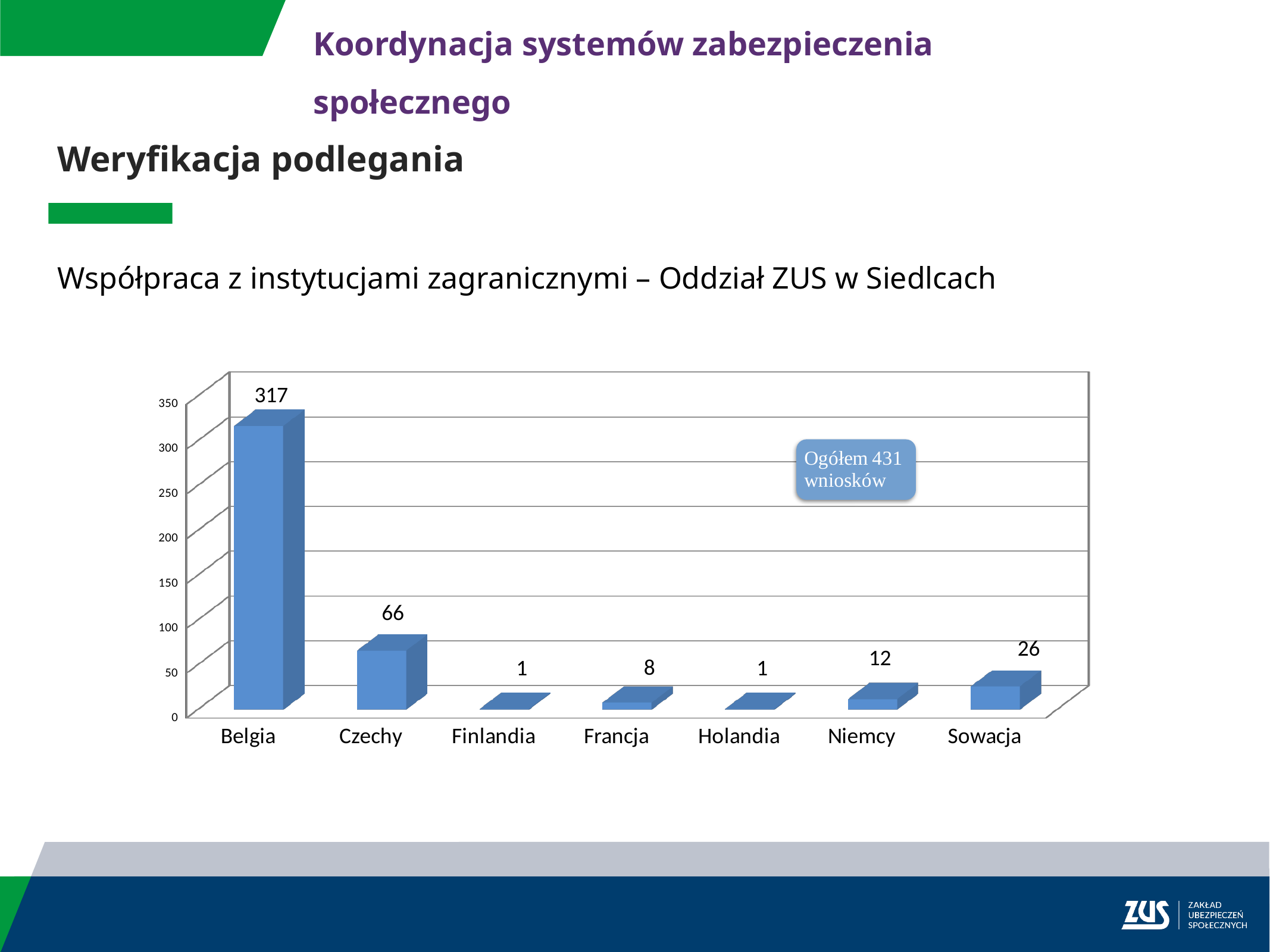
Which category has the highest value? Belgia What kind of chart is shown on the slide? bar chart What is the value for Belgia? 317 What is the value for Sowacja? 26 How many categories are shown on the x axis? 7 What is the value for Czechy? 66 What is the difference between the values for Sowacja and Niemcy? 14 Which is larger, the value for Francja or the value for Niemcy? Niemcy What total number of applications does the text box on the chart state? 431 What is the difference between the values for Belgia and Czechy? 251 What is the value for Niemcy? 12 Is the value for Belgia greater or less than 300? greater